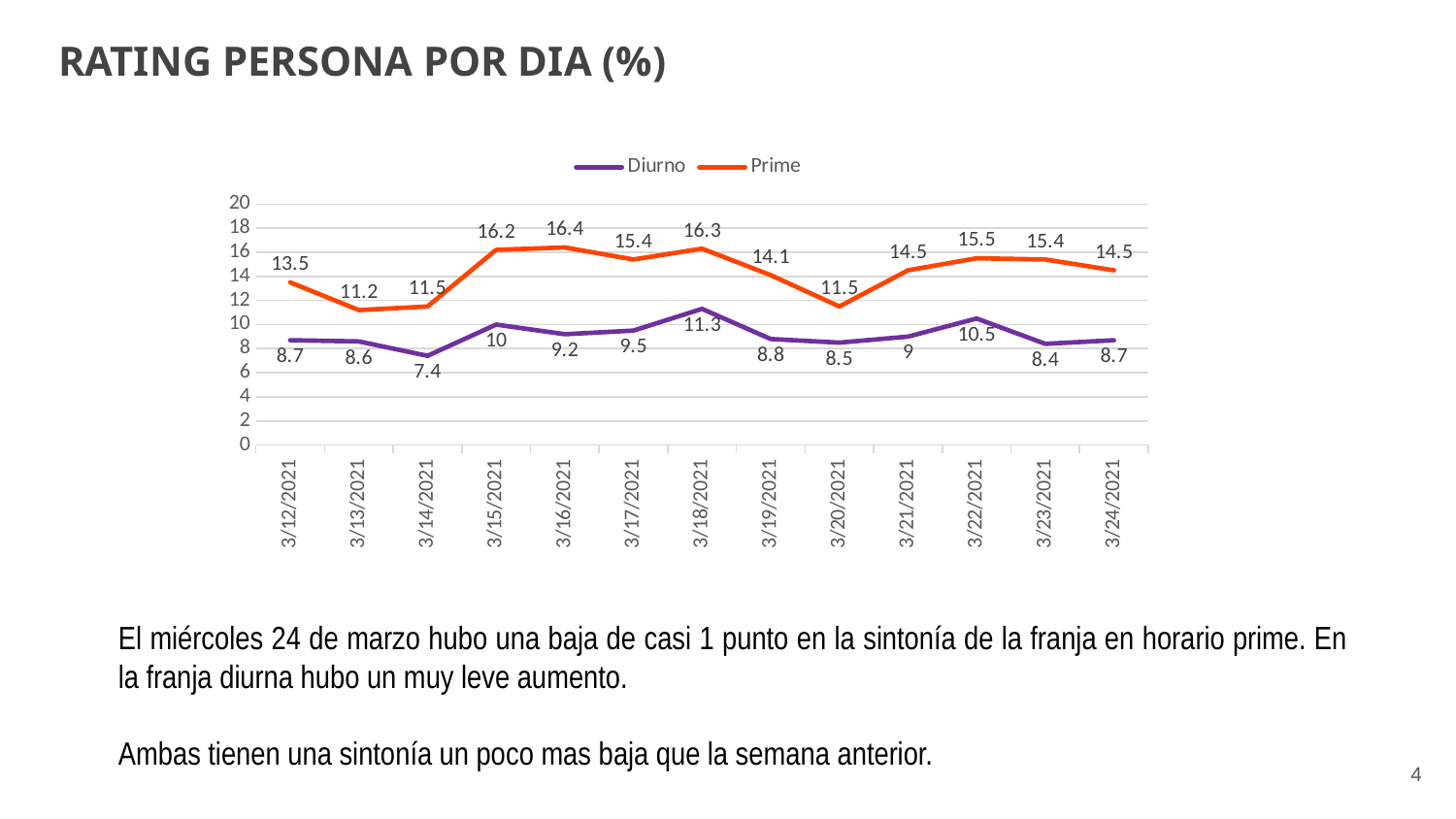
On which date is the Prime series highest? 3/16/2021 How many dates are plotted on the x axis? 13 Does the Prime series rise or fall from 3/12/2021 to 3/13/2021? Fall How many series does the legend list? 2 What is the Diurno value on 3/18/2021? 11.3 On which date is the Prime series lowest? 3/13/2021 Which is larger, the Diurno value on 3/22/2021 or on 3/23/2021? 3/22/2021 What is the Prime value on 3/24/2021? 14.5 On which date is the Diurno series lowest? 3/14/2021 What kind of chart is shown on the slide? Line chart What is the difference between the Prime and Diurno values on 3/24/2021? 5.8 What is the Prime value on 3/16/2021? 16.4